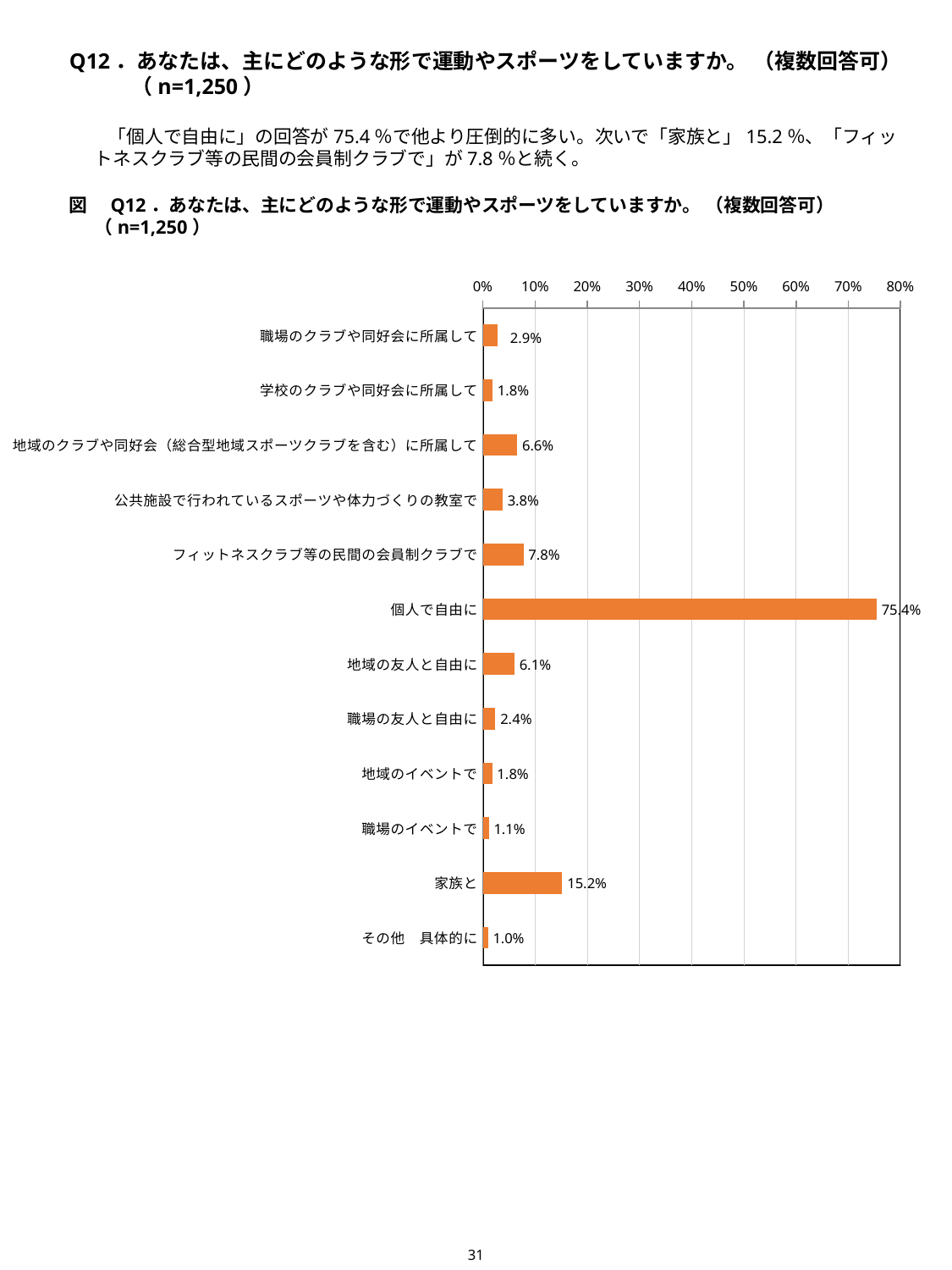
What is the value for 個人で自由に? 75.4% Which is larger, 地域のクラブや同好会（総合型地域スポーツクラブを含む）に所属して or 公共施設で行われているスポーツや体力づくりの教室で? 地域のクラブや同好会（総合型地域スポーツクラブを含む）に所属して What is the value for 家族と? 15.2% Is the value for 個人で自由に greater or less than 70%? greater Which category has the highest value? 個人で自由に Which category has the lowest value? その他 具体的に What kind of chart is shown? bar chart How many categories are shown in the chart? 12 What is the sample size (n) stated in the chart title? 1,250 What is the value for 地域の友人と自由に? 6.1% What is the value for フィットネスクラブ等の民間の会員制クラブで? 7.8% What is the difference between 個人で自由に and 家族と? 60.2%